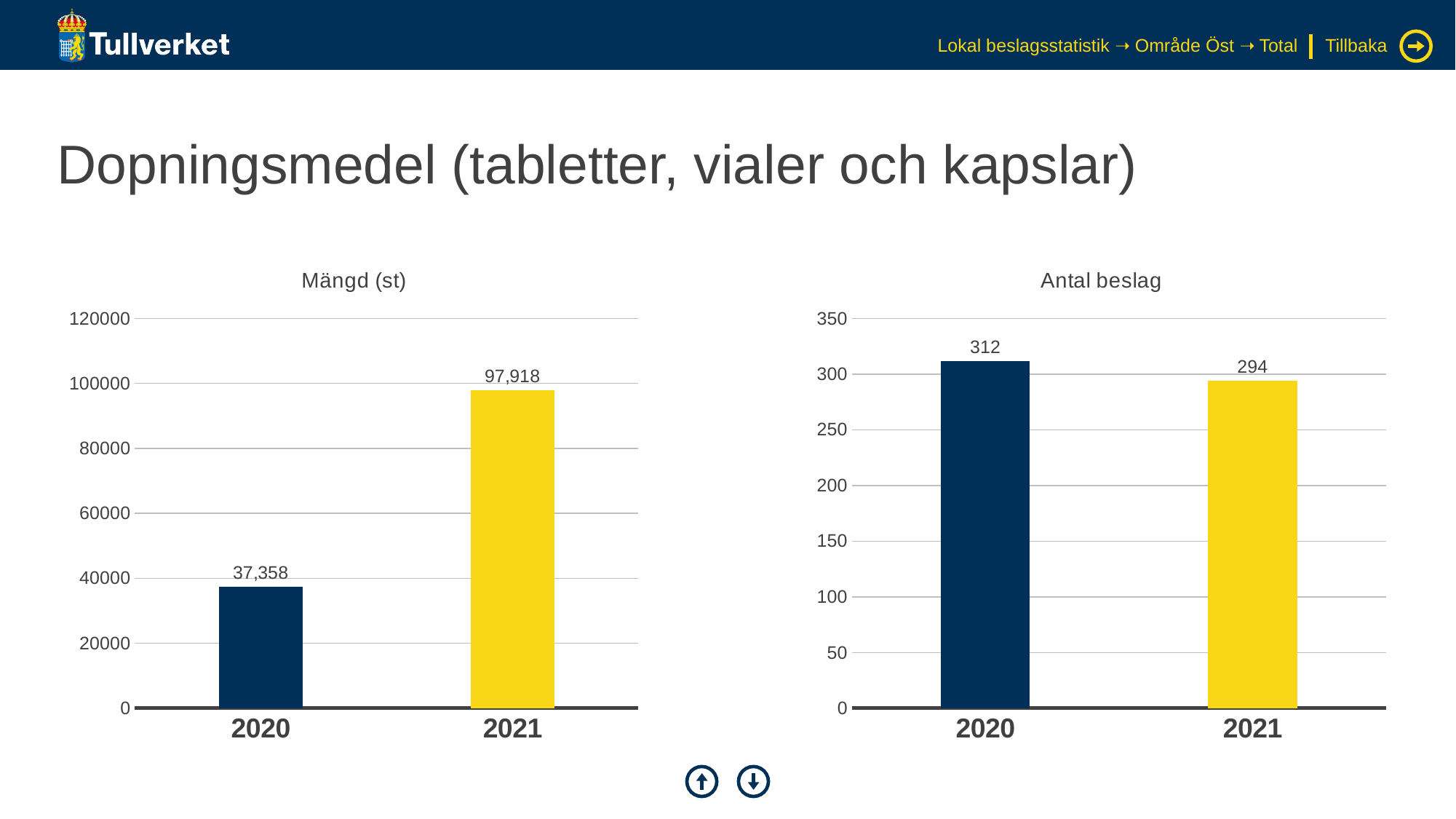
In the 'Antal beslag' chart, what is the value for 2021? 294 In the 'Mängd (st)' chart, what is the difference between the 2021 and 2020 values? 60,560 In the 'Mängd (st)' chart, what is the value for 2021? 97,918 In the 'Mängd (st)' chart, what is the value for 2020? 37,358 In the 'Mängd (st)' chart, how many years are shown on the x axis? 2 In the 'Antal beslag' chart, what is the difference between the 2020 and 2021 values? 18 In the 'Antal beslag' chart, which year has the lowest value? 2021 In the 'Mängd (st)' chart, which year has the highest value? 2021 In the 'Antal beslag' chart, what is the value for 2020? 312 What kind of chart is the 'Antal beslag' chart? Bar chart In the 'Antal beslag' chart, do the values rise or fall from 2020 to 2021? Fall In the 'Antal beslag' chart, is the value for 2020 greater or less than 300? greater